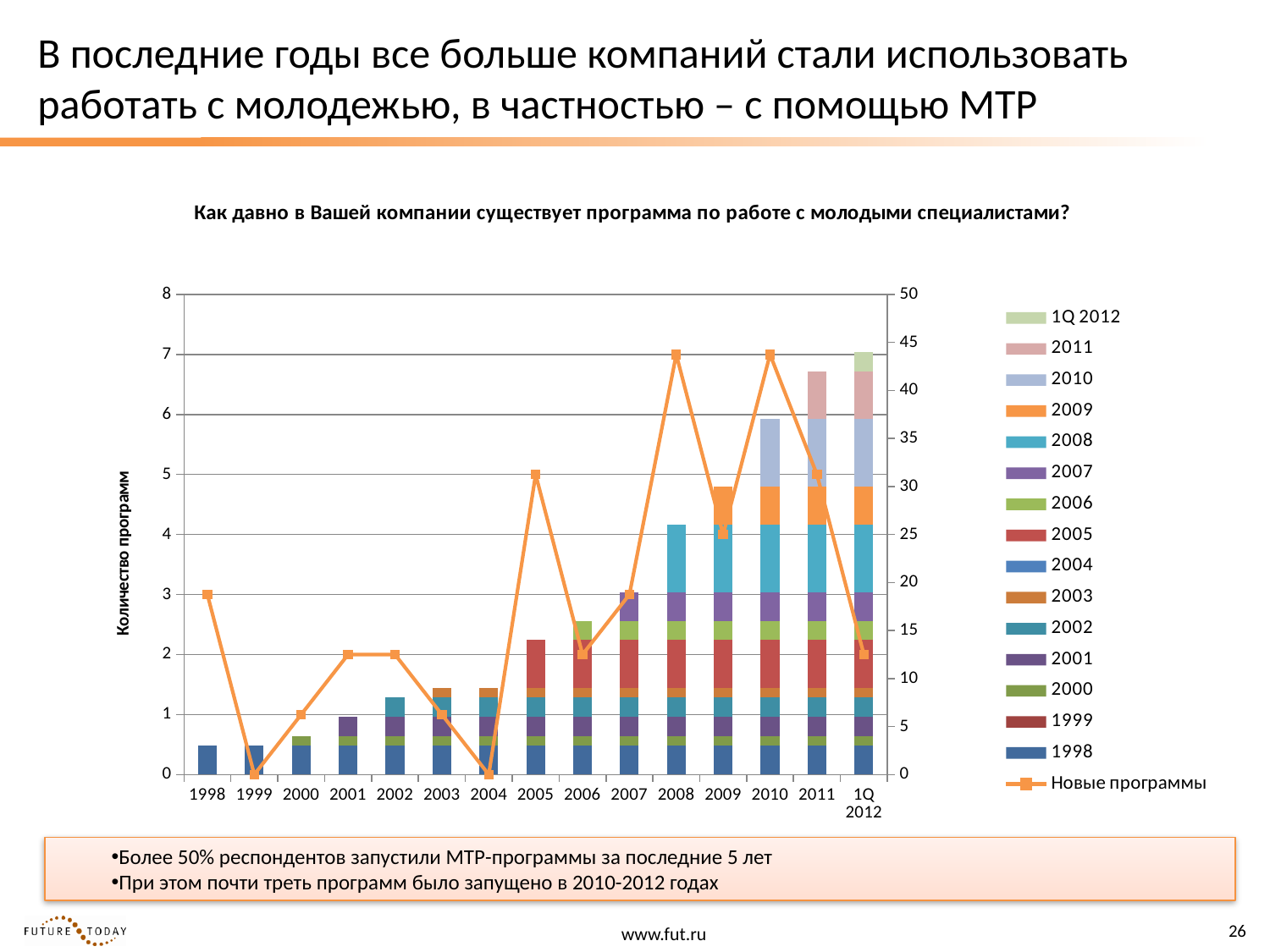
Is the total stacked bar for 2006 greater or less than 3 on the left axis? less How many series does the chart's legend list? 16 What kind of chart is shown on the slide? A stacked bar chart combined with a line How many categories are shown along the x axis of the chart? 15 Do the stacked bar totals generally rise or fall from 1998 to 1Q 2012? rise What is the name of the line series in the chart's legend? Новые программы Is the 'Новые программы' line value for 2008 greater or less than 40 on the right axis? greater Which has the taller stacked bar, 2009 or 2010? 2010 Is the total stacked bar for 2003 greater or less than 2 on the left axis? less Which category has the tallest stacked bar? 1Q 2012 What is the title of the chart? Как давно в Вашей компании существует программа по работе с молодыми специалистами?